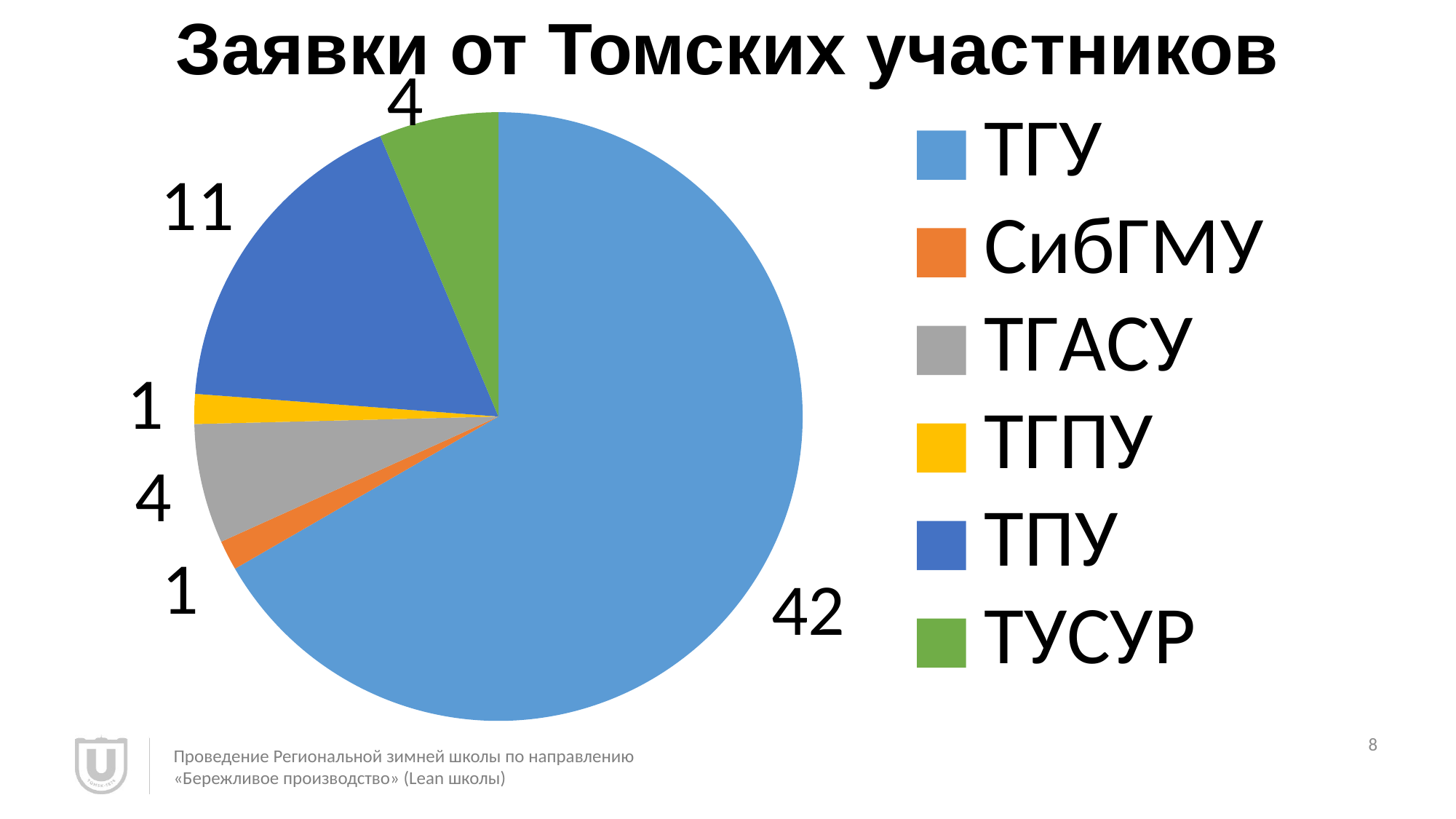
What is the value for ТГАСУ? 4 What kind of chart is shown on the slide? pie chart What is the value for ТПУ? 11 What is the title of the chart? Заявки от Томских участников What is the value for ТГУ? 42 Which is larger, the value for ТПУ or the value for ТГАСУ? ТПУ What is the value for СибГМУ? 1 Which category has the largest slice? ТГУ How many categories does the pie chart have? 6 What is the value for ТУСУР? 4 What is the difference between the values for ТГУ and ТПУ? 31 What colour is the slice for ТУСУР? green